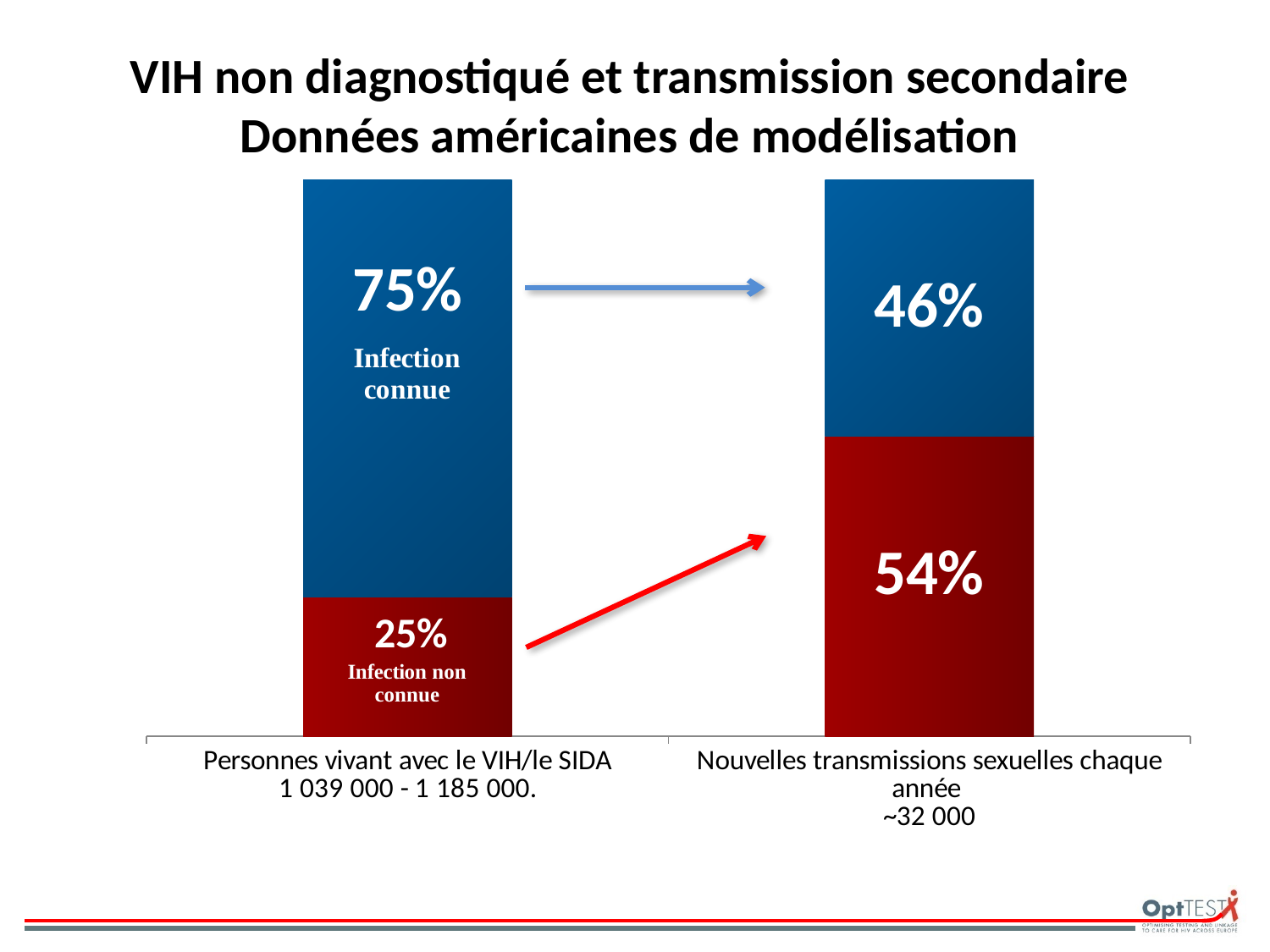
What is the total of the two segments in the bar for people living with HIV/AIDS? 100% What share of people living with HIV/AIDS (Personnes vivant avec le VIH/le SIDA) has an unknown infection (Infection non connue)? 25% In the bar for new sexual transmissions each year, which segment is larger: known infection (blue) or unknown infection (red)? Unknown infection (red), 54% What is the difference between the known-infection share among people living with HIV/AIDS (75%) and the known-infection share of new sexual transmissions (46%)? 29 percentage points What percentage of new sexual transmissions each year (Nouvelles transmissions sexuelles chaque année) comes from people with an unknown infection (red segment)? 54% What type of chart is shown on the slide? Stacked bar chart How many bars (categories) does the chart show? 2 Which is larger: the unknown-infection share among people living with HIV/AIDS or the unknown-infection share of new sexual transmissions each year? New sexual transmissions each year (54%) Which colour represents 'Infection non connue' (unknown infection) in the chart? Red What is the difference between the unknown-infection share of new sexual transmissions (54%) and the unknown-infection share among people living with HIV/AIDS (25%)? 29 percentage points What percentage of new sexual transmissions each year (Nouvelles transmissions sexuelles chaque année) comes from people with a known infection (blue segment)? 46% What share of people living with HIV/AIDS (Personnes vivant avec le VIH/le SIDA) has a known infection (Infection connue)? 75%